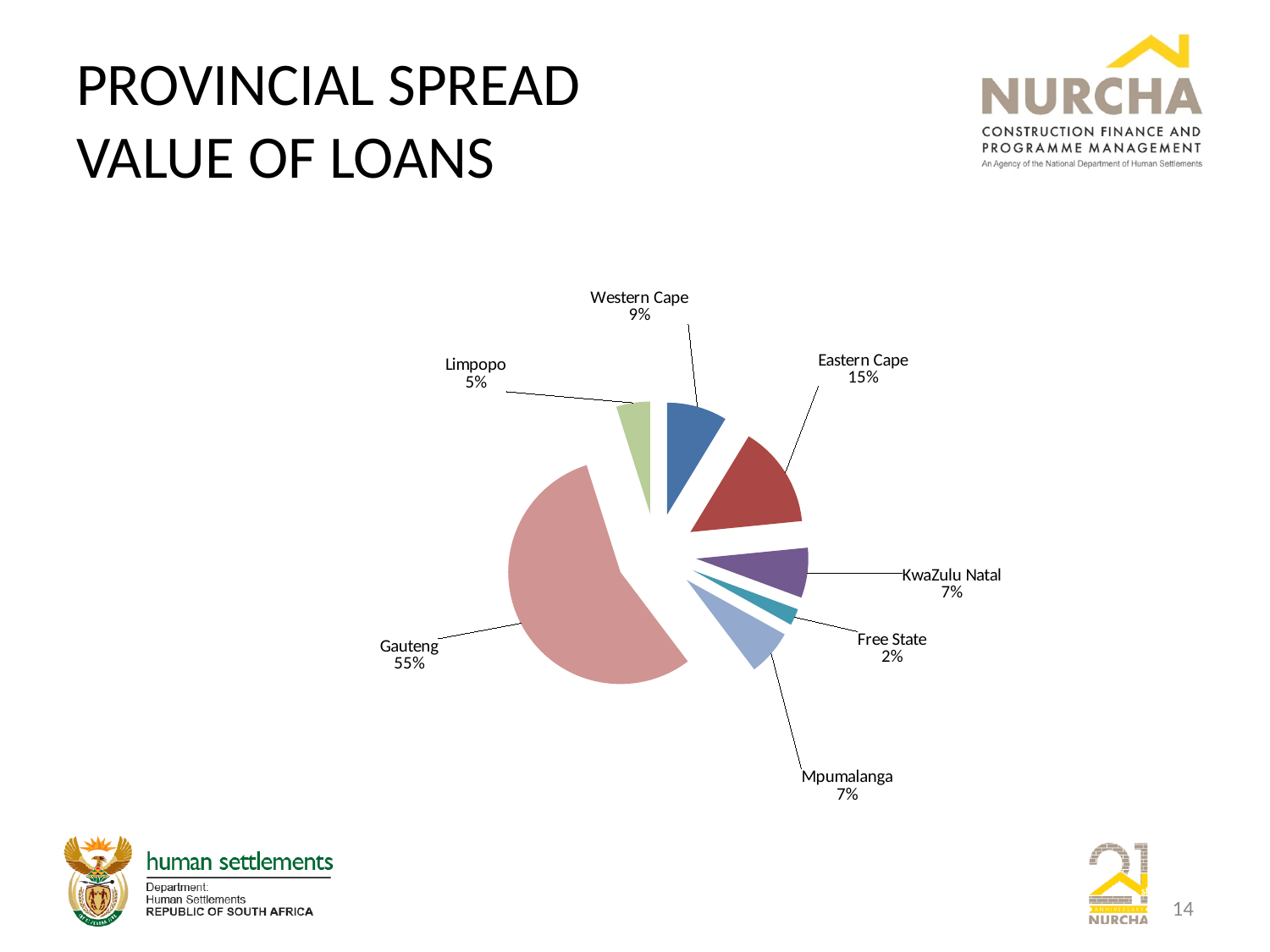
Which province has the smallest share of the value of loans? Free State Which has a larger share, Western Cape or Limpopo? Western Cape How many provinces are shown in the pie chart? 7 What share of the value of loans does Gauteng account for? 55% What percentage is shown for Western Cape? 9% What is the title of the slide containing the chart? PROVINCIAL SPREAD VALUE OF LOANS What type of chart is shown on the slide? Pie chart What percentage is shown for Limpopo? 5% Which province has the largest share of the value of loans? Gauteng What is the difference in percentage points between Gauteng and Eastern Cape? 40 What percentage is shown for Eastern Cape? 15% What is the combined share of KwaZulu Natal and Mpumalanga? 14%